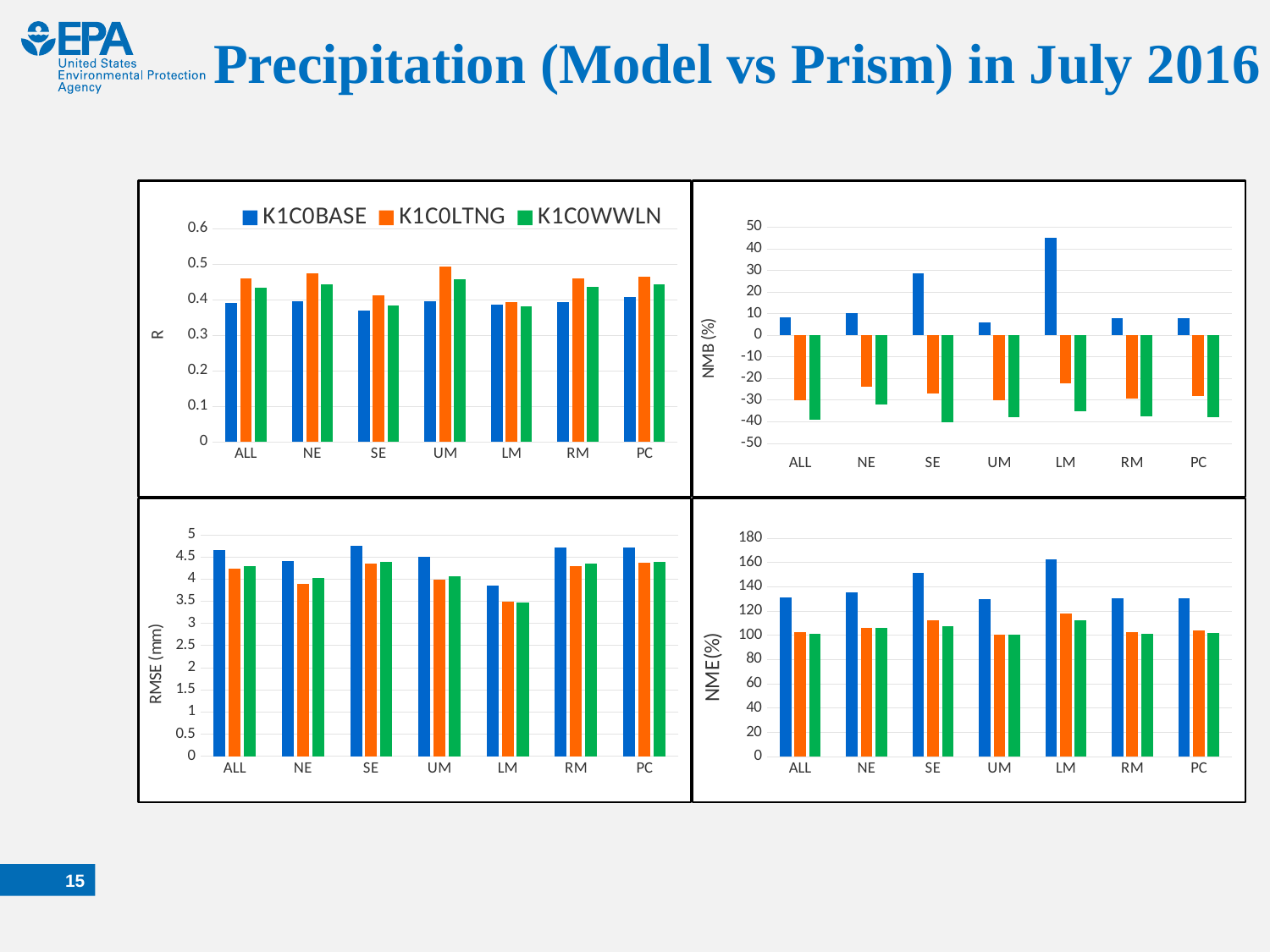
How many series does the legend on the top-left R chart list? 3 What kind of chart is the top-left chart with the R axis? bar chart How many categories are shown on the x axis of the bottom-right NME(%) chart? 7 In the top-right NMB (%) chart, which is larger for K1C0BASE: SE or NE? SE In the bottom-right NME(%) chart, is the K1C0BASE value for LM greater or less than 140? greater In the bottom-right NME(%) chart, which category has the highest K1C0BASE bar? LM What are the three series names listed in the legend of the top-left R chart? K1C0BASE, K1C0LTNG, K1C0WWLN In the bottom-right NME(%) chart, which is larger for K1C0BASE: SE or UM? SE In the top-right NMB (%) chart, which category and series has the highest value? K1C0BASE at LM In the top-right NMB (%) chart, is the K1C0BASE value for LM greater or less than 40? greater In the bottom-left RMSE (mm) chart, is the K1C0LTNG value for LM greater or less than 4? less In the bottom-left RMSE (mm) chart, which is larger for K1C0BASE: SE or LM? SE